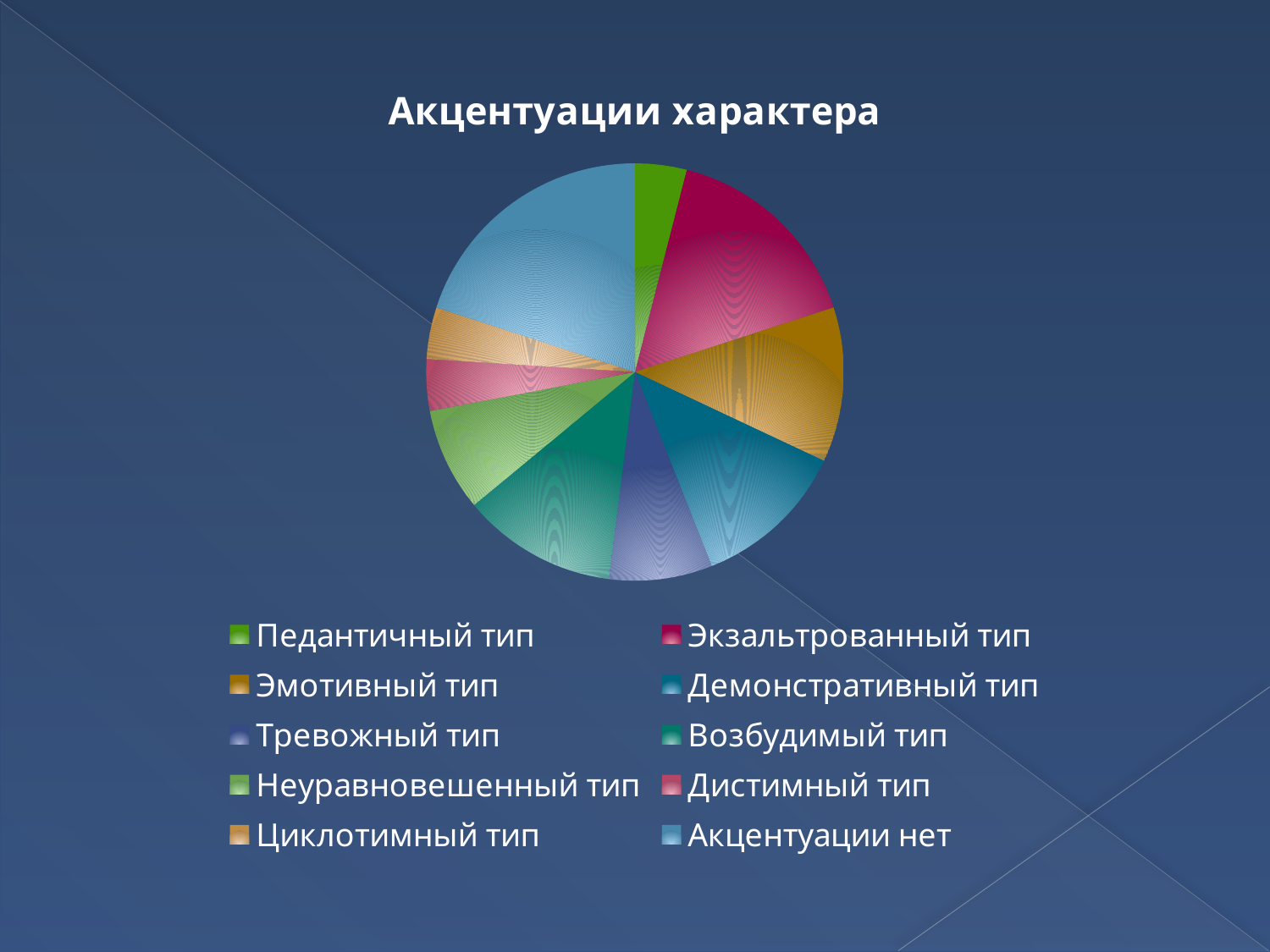
Which legend entry is shown in light blue? Акцентуации нет Which slice is larger: Акцентуации нет or Педантичный тип? Акцентуации нет Which slice is larger: Возбудимый тип or Дистимный тип? Возбудимый тип How many categories (slices) does the pie chart have? 10 Which category has the largest slice of the pie? Акцентуации нет What is the title of the chart? Акцентуации характера What kind of chart is shown on the slide? pie chart Which slice is larger: Демонстративный тип or Тревожный тип? Демонстративный тип How many entries does the legend list? 10